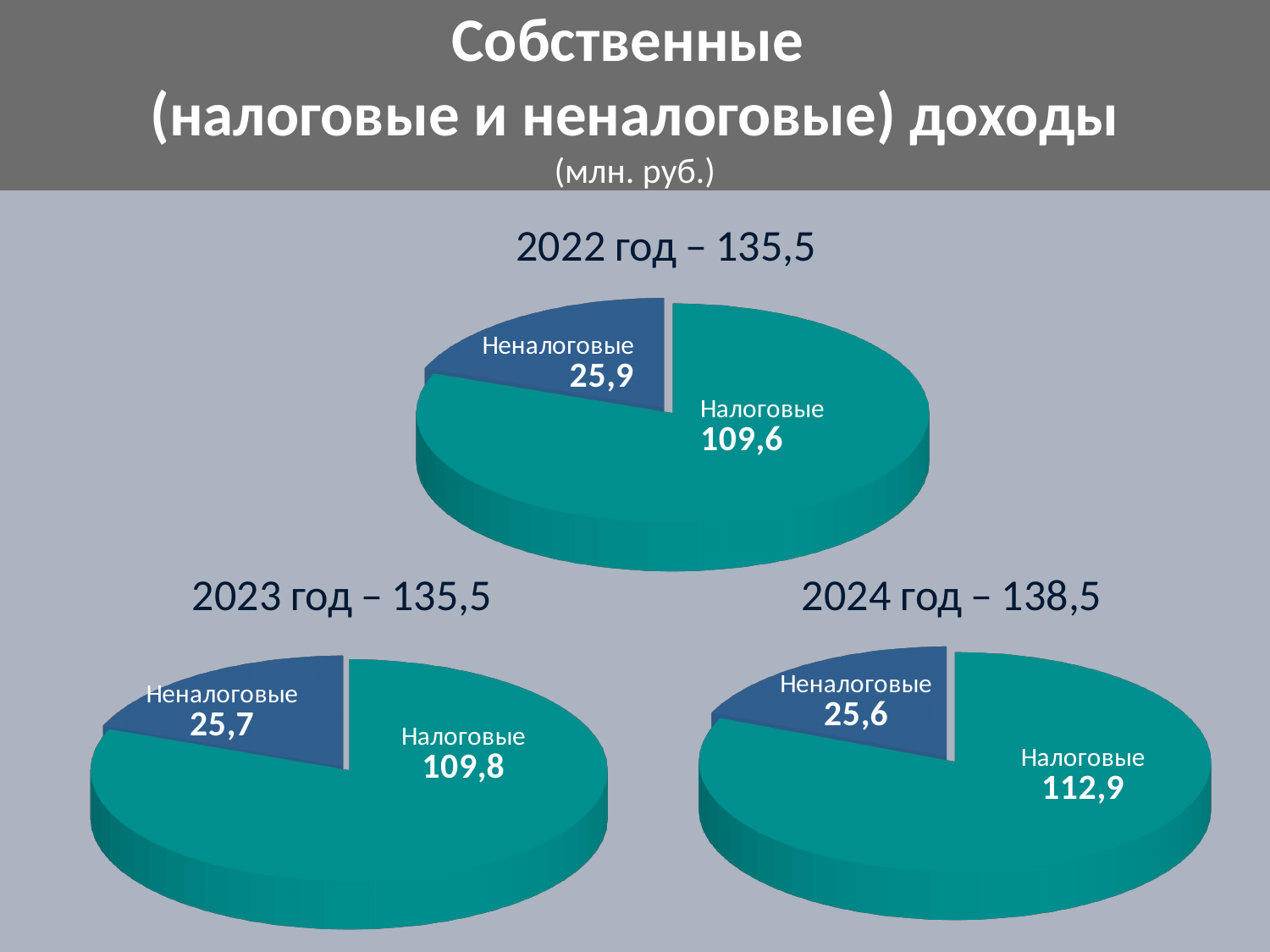
In the 2024 год pie chart, what is the difference between Налоговые and Неналоговые? 87,3 In the 2022 год pie chart, what is the difference between Налоговые and Неналоговые? 83,7 How many slices does the 2023 год pie chart have? 2 In the 2023 год pie chart, what is the value for Налоговые? 109,8 In the 2023 год pie chart, which slice is the smallest? Неналоговые In the 2022 год pie chart, what is the value for Неналоговые? 25,9 In the 2024 год pie chart, which slice is the largest? Налоговые What total is shown in the heading of the 2024 год chart? 138,5 In the 2024 год pie chart, what is the value for Неналоговые? 25,6 In the 2022 год pie chart, what is the value for Налоговые? 109,6 What type of chart is used for the 2022 год data? pie chart Is the Налоговые value in the 2024 год chart larger or smaller than the Налоговые value in the 2023 год chart? larger